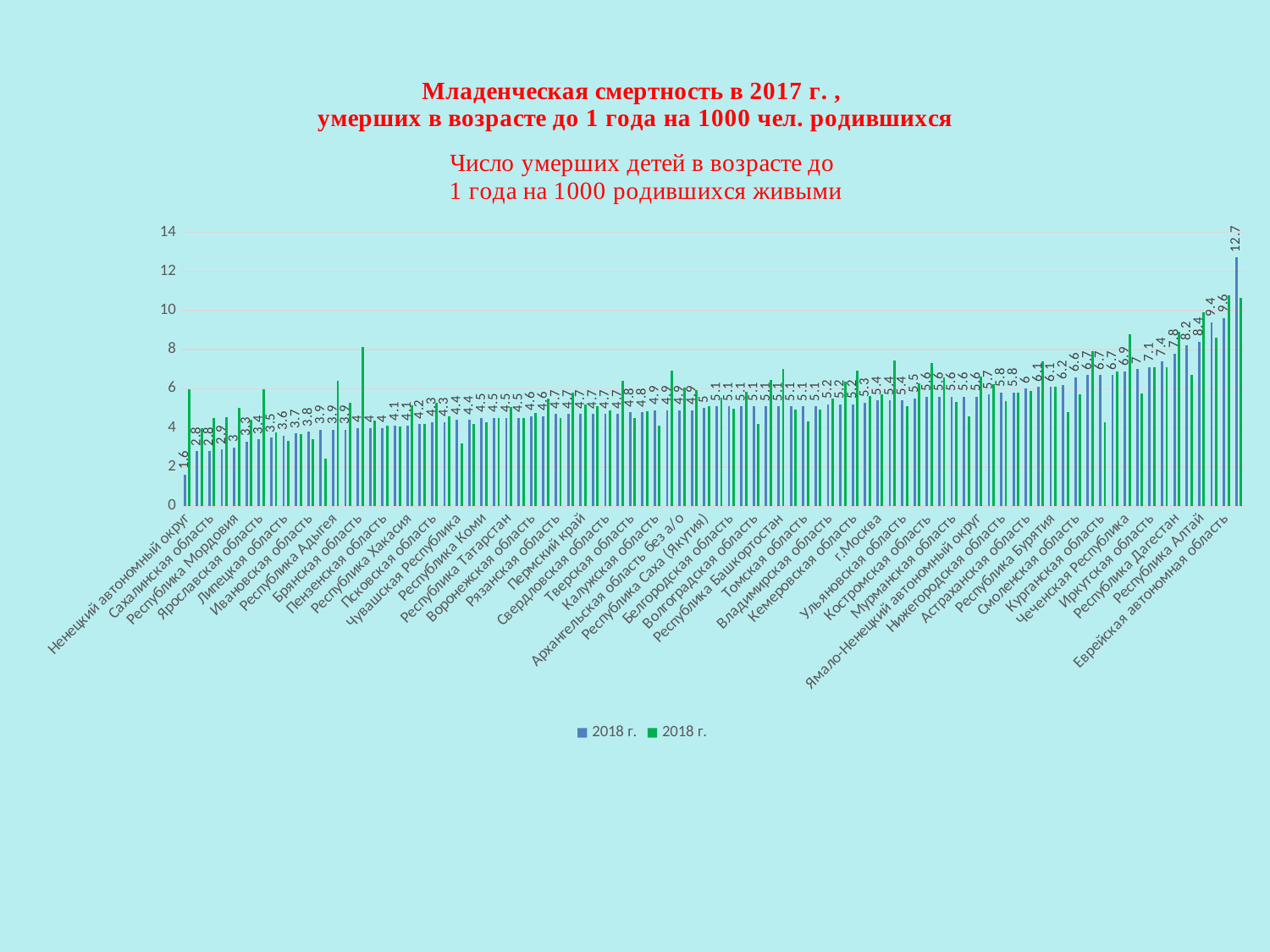
What text is shown for the legend entries of the chart? 2018 г. and 2018 г. How many series does the chart legend list? 2 Which region has the lowest labelled value on the chart? Ненецкий автономный округ Is the labelled value for Еврейская автономная область greater or less than 12? less What is the difference between the labelled values for Еврейская автономная область and Ненецкий автономный округ? 8 What is the title of the chart? Число умерших детей в возрасте до 1 года на 1000 родившихся живыми Do the labelled values generally rise or fall from left to right along the x axis? rise What kind of chart is shown on the slide? bar chart What is the labelled value for Еврейская автономная область? 9.6 Which has the larger labelled value, Еврейская автономная область or Ненецкий автономный округ? Еврейская автономная область What is the labelled value for Ненецкий автономный округ? 1.6